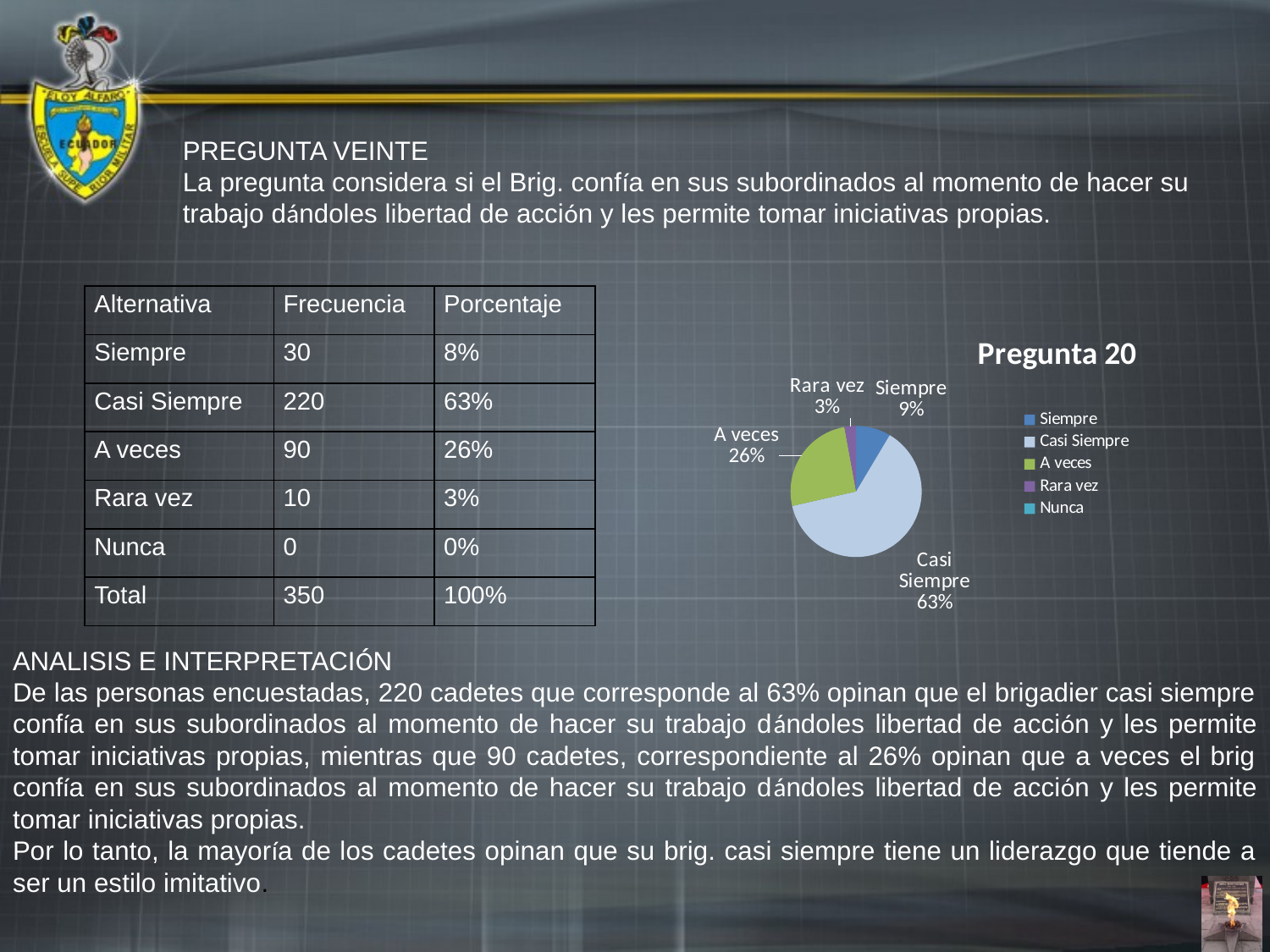
Which slice is larger in the pie chart, A veces or Siempre? A veces Which category has the largest slice in the pie chart? Casi Siempre What percentage does the chart show for A veces? 26% Which legend entry is shown in green in the pie chart? A veces What percentage does the chart show for Rara vez? 3% What percentage does the chart show for Siempre? 9% What type of chart is shown on the slide? Pie chart What is the difference in percentage points between the Casi Siempre and A veces slices? 37 What percentage does the chart show for Casi Siempre? 63% What is the title of the chart? Pregunta 20 How many entries does the chart legend list? 5 Which labelled slice in the pie chart is the smallest? Rara vez